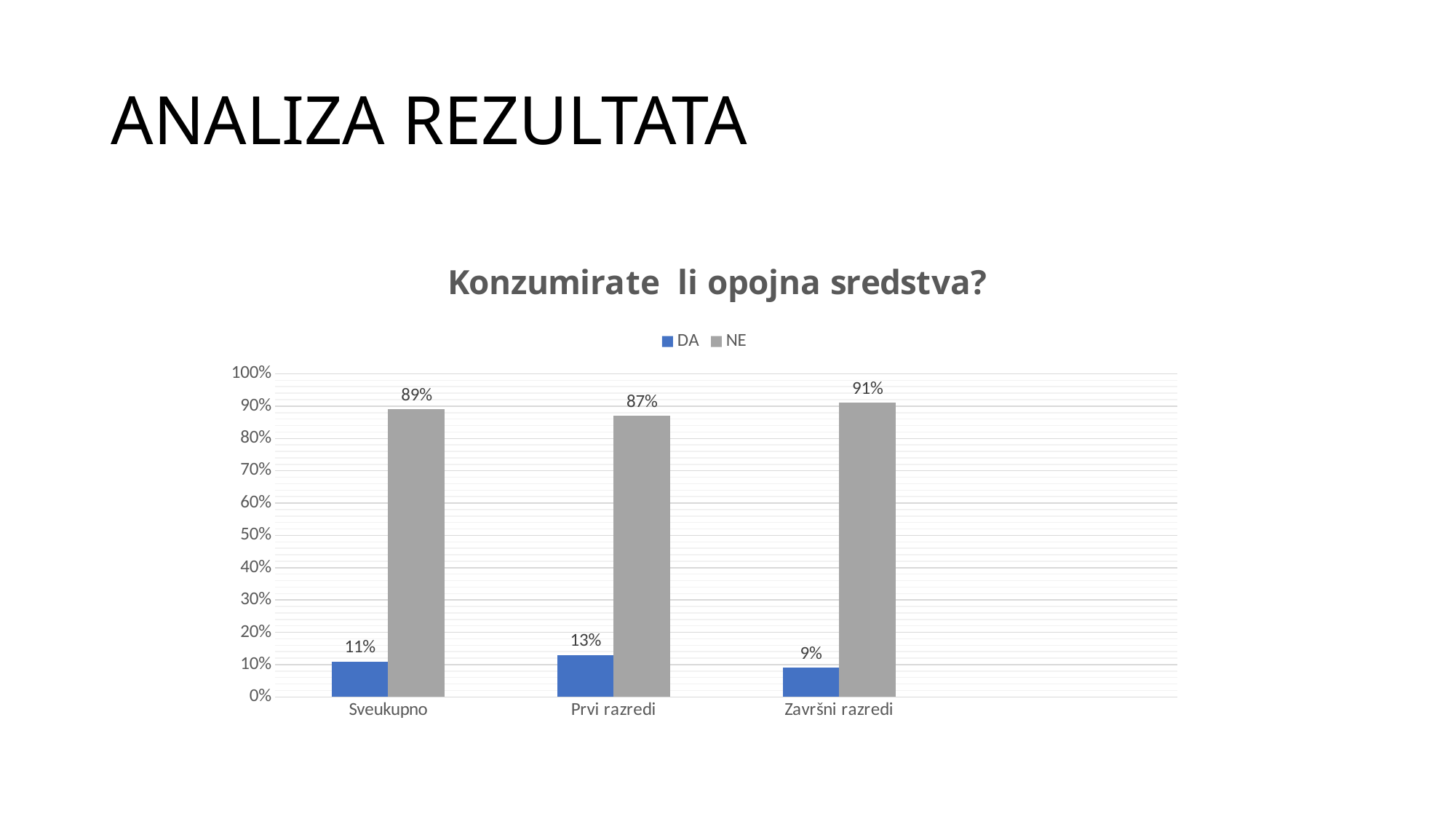
What kind of chart is shown on the slide? Bar chart How many series does the legend list? 2 Which category has the highest DA value? Prvi razredi Which is larger: the DA value for Sveukupno or the DA value for Završni razredi? Sveukupno What is the NE value for Završni razredi? 91% What is the difference between the NE value for Završni razredi and the NE value for Sveukupno? 2% What is the title of the chart? Konzumirate li opojna sredstva? Which category has the lowest NE value? Prvi razredi What is the DA value for Završni razredi? 9% What is the DA value for Sveukupno? 11% What is the NE value for Prvi razredi? 87% How many categories are shown on the x axis? 3